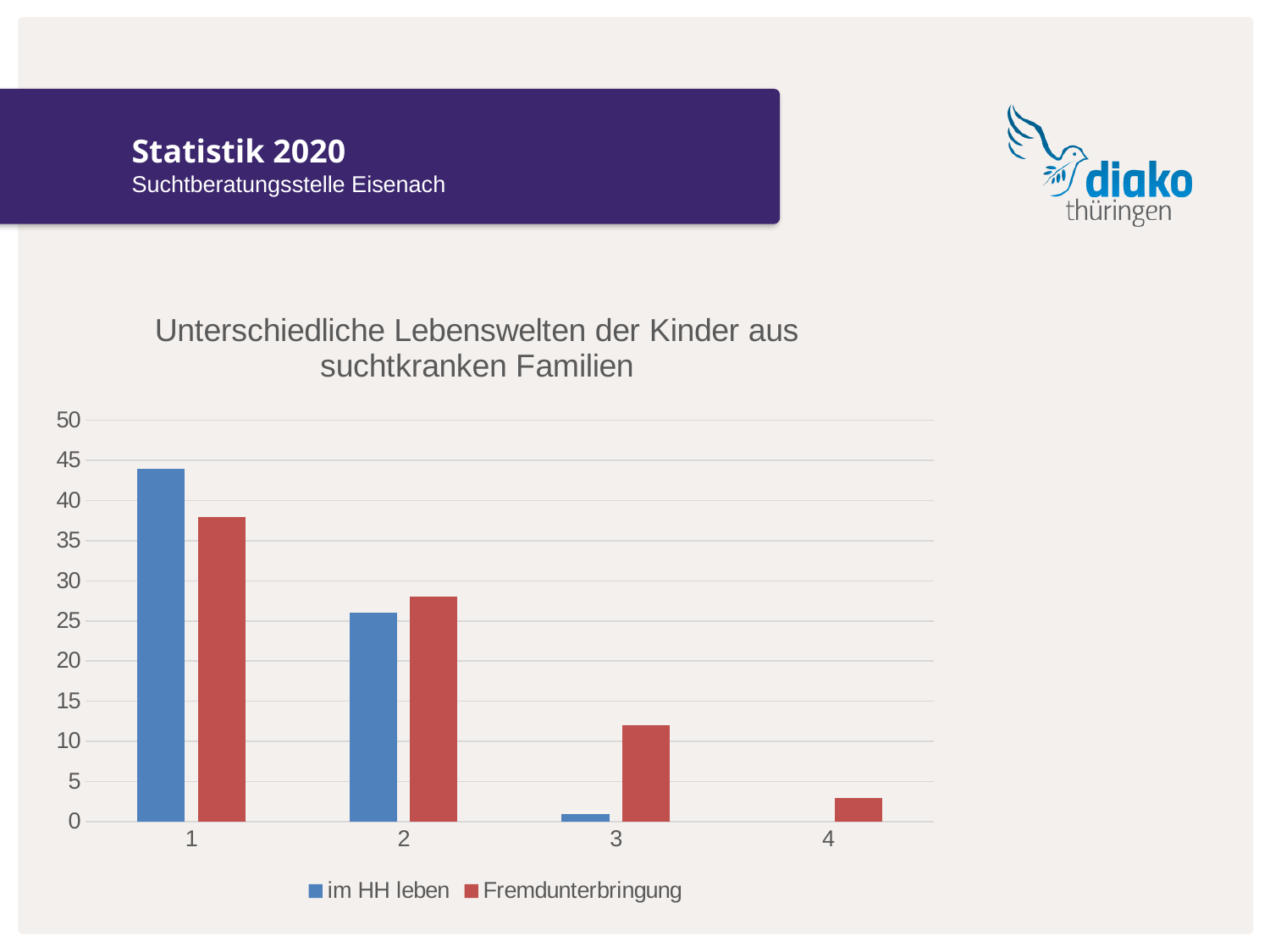
Which series is shown in red? Fremdunterbringung How many categories are shown on the x axis? 4 Is the value for 'im HH leben' at category 1 greater or less than 40? greater Is the value for 'Fremdunterbringung' at category 3 greater or less than 10? greater Is the value for 'Fremdunterbringung' at category 1 greater or less than 40? less At category 3, which series has the larger value, 'im HH leben' or 'Fremdunterbringung'? Fremdunterbringung What kind of chart is shown on the slide? bar chart For which category is the 'Fremdunterbringung' value lowest? 4 What is the title of the chart? Unterschiedliche Lebenswelten der Kinder aus suchtkranken Familien How many series does the legend list? 2 For which category is the 'im HH leben' value highest? 1